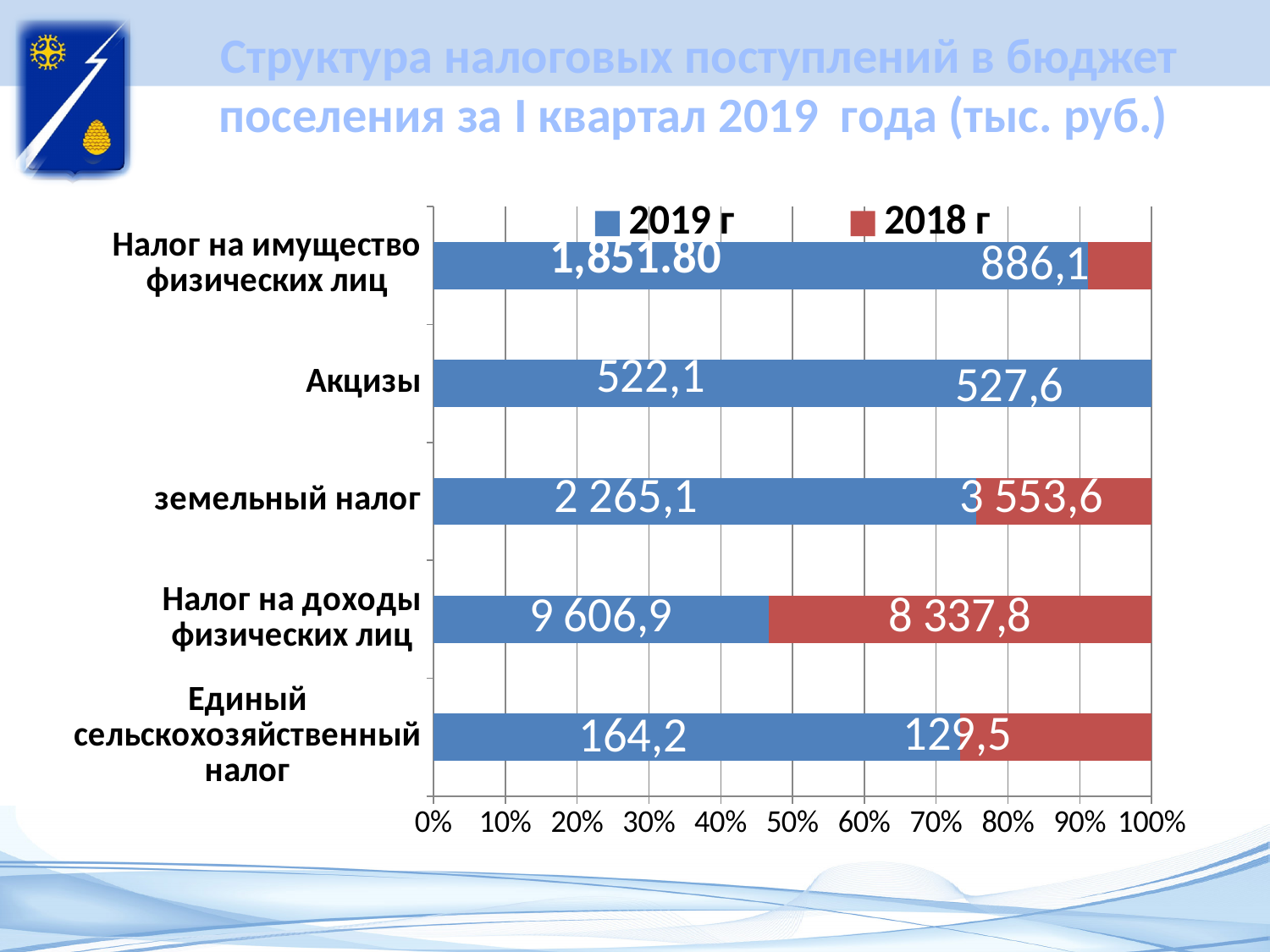
Which category has the highest 2019 г value? Налог на доходы физических лиц How many series does the legend list? 2 What is the 2019 г value for Налог на доходы физических лиц? 9 606,9 What is the difference between the 2019 г and 2018 г values for Налог на доходы физических лиц? 1 269,1 What is the difference between the 2018 г and 2019 г values for земельный налог? 1 288,5 What is the 2018 г value for Единый сельскохозяйственный налог? 129,5 What is the 2019 г value for Акцизы? 522,1 Which category has the lowest 2018 г value? Единый сельскохозяйственный налог What is the 2018 г value for земельный налог? 3 553,6 How many tax categories are shown on the chart? 5 What kind of chart is shown on the slide? Stacked bar chart For Налог на имущество физических лиц, which is larger: the 2019 г value or the 2018 г value? 2019 г